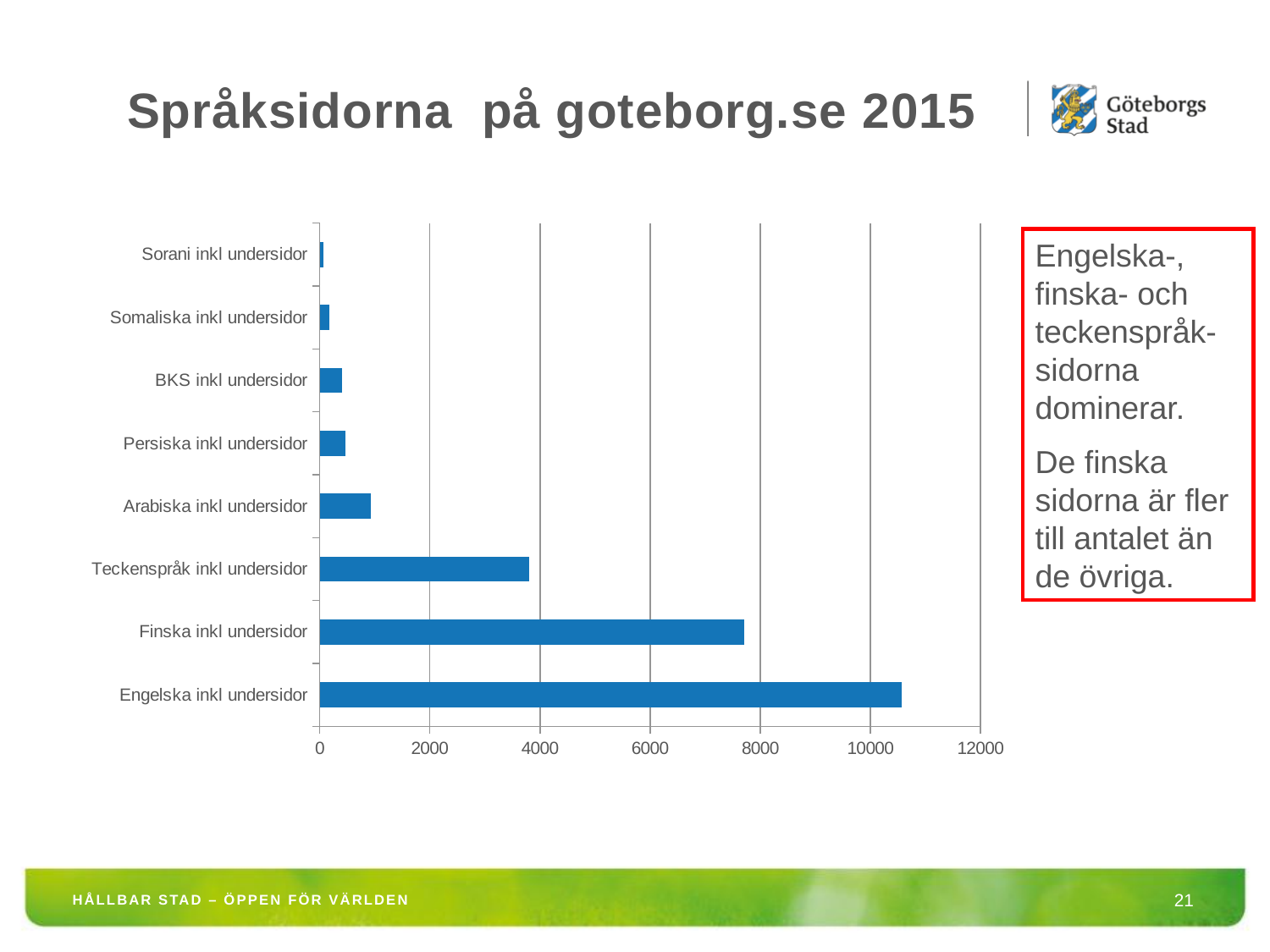
Is the value for Finska inkl undersidor greater or less than 8000? less What kind of chart is shown on the slide? Bar chart How many categories are plotted in the chart? 8 What is the title of the slide containing the chart? Språksidorna på goteborg.se 2015 Is the value for Teckenspråk inkl undersidor greater or less than 4000? less Which category has the lowest value in the chart? Sorani inkl undersidor Which category has the highest value in the chart? Engelska inkl undersidor Is the value for Arabiska inkl undersidor greater or less than 2000? less Which is larger, the value for Finska inkl undersidor or Teckenspråk inkl undersidor? Finska inkl undersidor What colour are the bars in the chart? Blue Which is larger, the value for Arabiska inkl undersidor or Persiska inkl undersidor? Arabiska inkl undersidor